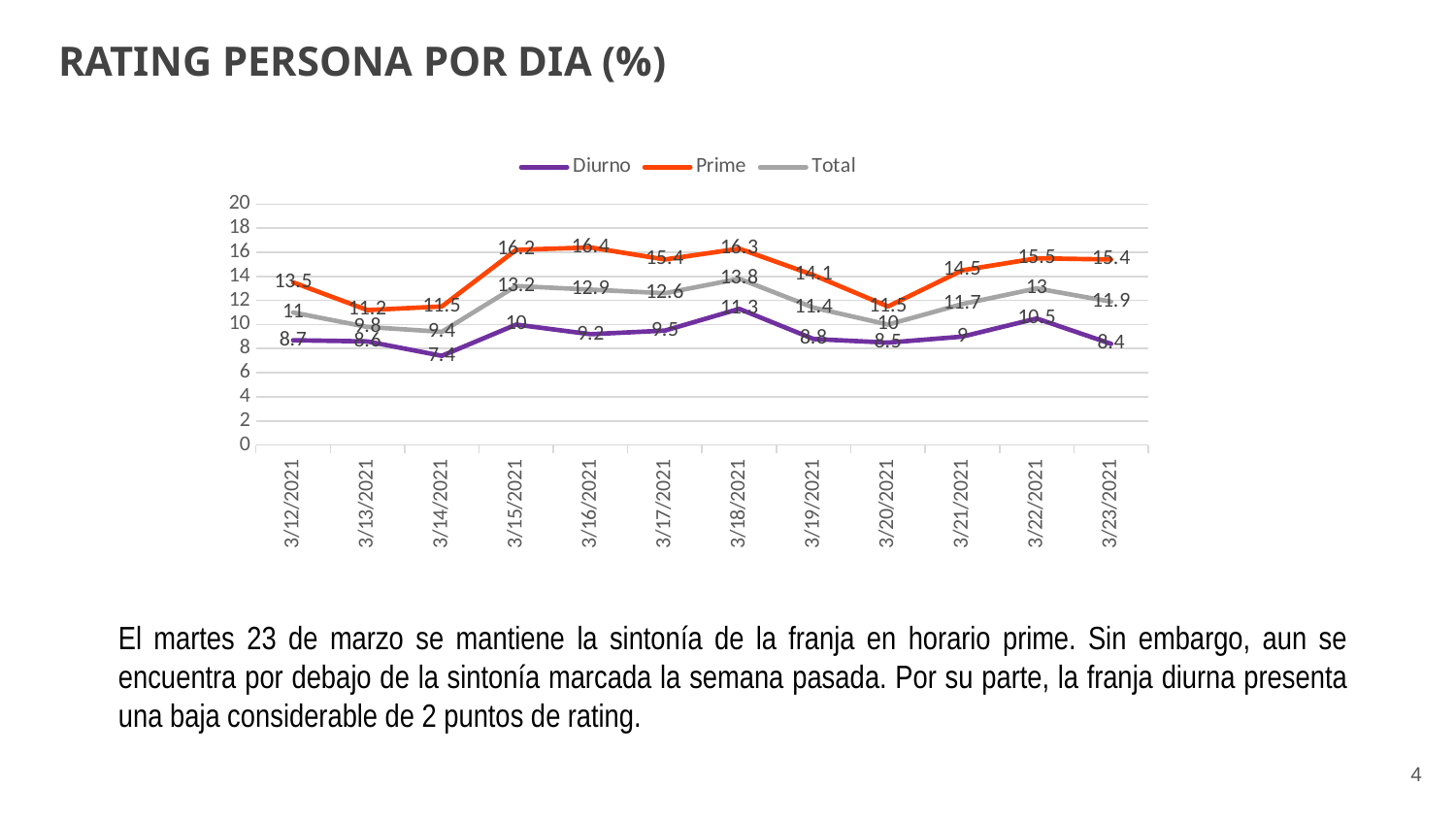
What is the difference between the Prime and Diurno values on 3/23/2021? 7 On which date is the Diurno series at its lowest? 3/14/2021 What is the Prime value on 3/16/2021? 16.4 How many dates are plotted along the x axis? 12 Which date has the higher Prime value, 3/15/2021 or 3/22/2021? 3/15/2021 What kind of chart is shown on the slide? Line chart What is the Total value on 3/18/2021? 13.8 What is the title of the chart? RATING PERSONA POR DIA (%) On which date is the Prime series at its highest? 3/16/2021 Is the Prime value on 3/12/2021 greater or less than 12? greater How many series does the legend list? 3 What is the Diurno value on 3/23/2021? 8.4